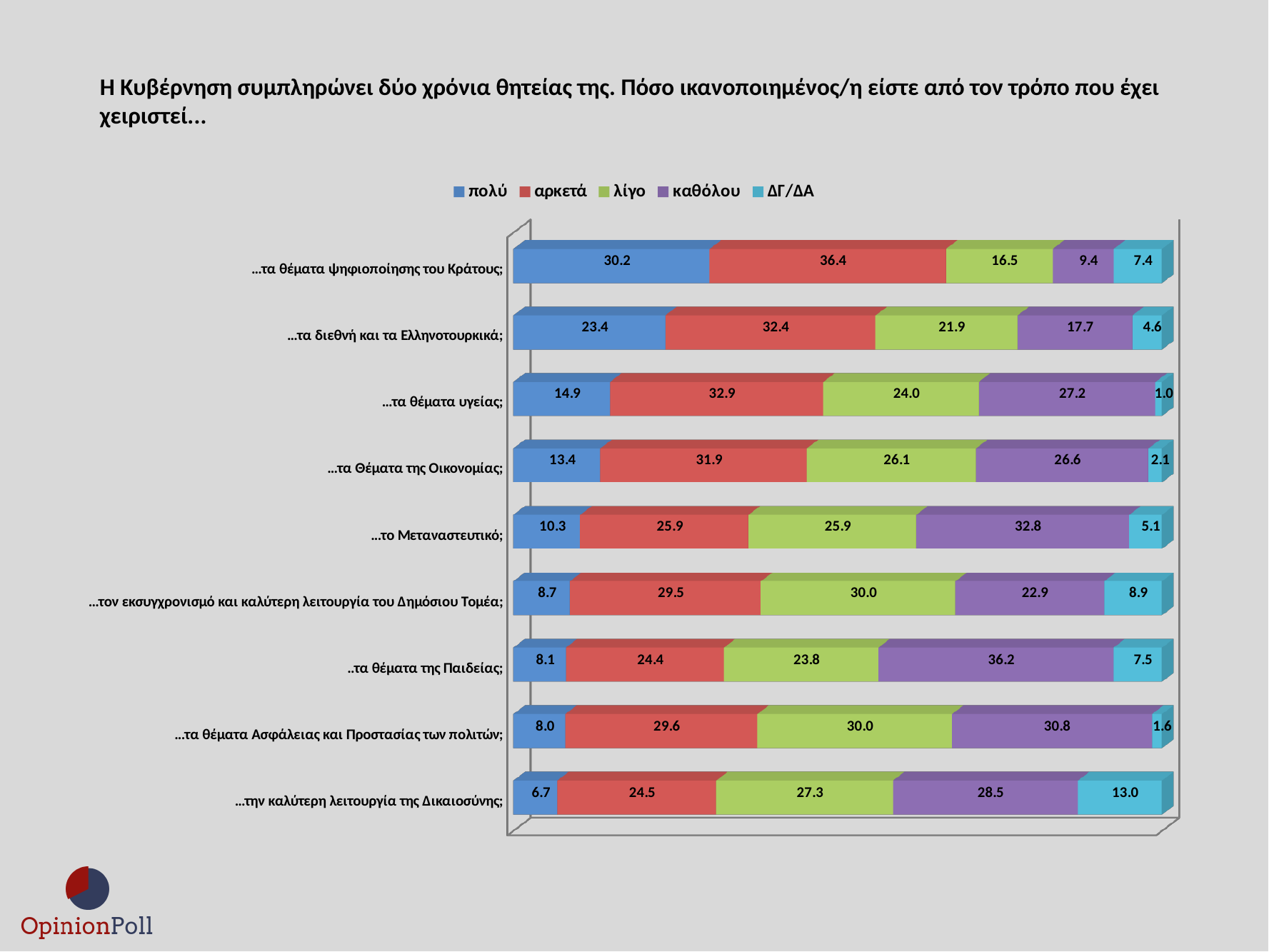
What is the difference between the "αρκετά" value for "...τα θέματα ψηφιοποίησης του Κράτους;" and for "..τα θέματα της Παιδείας;"? 12.0 Which category has the lowest value for "ΔΓ/ΔΑ"? ...τα θέματα υγείας; Which category has the highest value for "πολύ"? ...τα θέματα ψηφιοποίησης του Κράτους; What is the total of the stacked bar for "...τα θέματα υγείας;"? 100.0 What is the value of "ΔΓ/ΔΑ" for "...την καλύτερη λειτουργία της Δικαιοσύνης;"? 13.0 What is the value of "πολύ" for "...τα θέματα ψηφιοποίησης του Κράτους;"? 30.2 What kind of chart is shown on the slide? Stacked bar chart How many categories (bars) are plotted in the chart? 9 Which category has the lowest value for "πολύ"? ...την καλύτερη λειτουργία της Δικαιοσύνης; Which has the larger "καθόλου" value: "...το Μεταναστευτικό;" or "...τα θέματα Ασφάλειας και Προστασίας των πολιτών;"? ...το Μεταναστευτικό; How many series does the legend list? 5 What is the value of "καθόλου" for "..τα θέματα της Παιδείας;"? 36.2